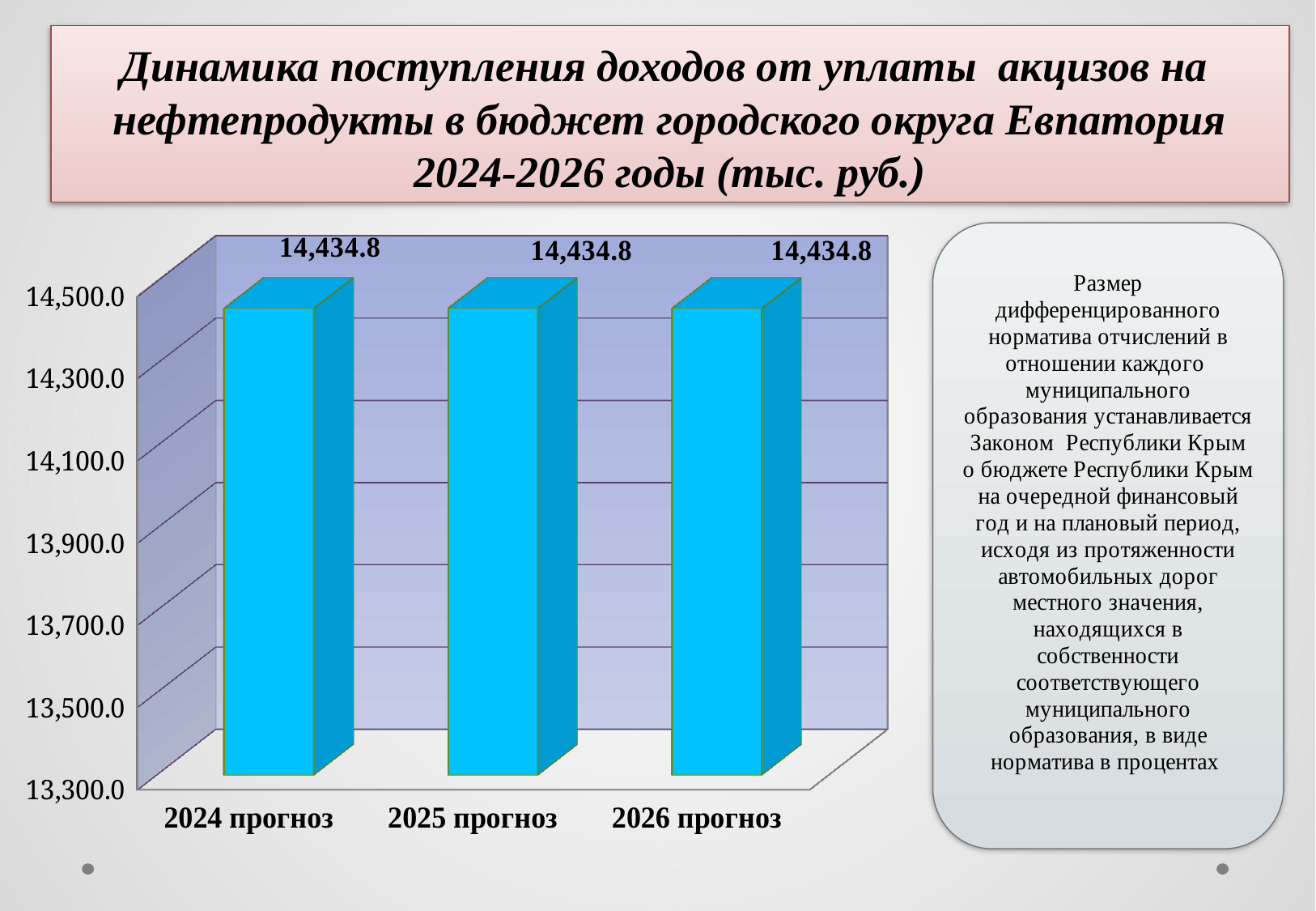
What kind of chart is shown on the slide? bar chart Is the value for 2025 прогноз greater or less than 14,300.0? greater What unit of measurement is stated in the slide title? тыс. руб. Is the value for 2024 прогноз greater or less than 14,500.0? less How many categories are shown on the x axis? 3 What is the difference between the values for 2024 прогноз and 2026 прогноз? 0.0 What is the lowest value shown on the vertical axis? 13,300.0 What is the value for 2026 прогноз? 14,434.8 What is the value for 2024 прогноз? 14,434.8 What is the value for 2025 прогноз? 14,434.8 Do the values rise, fall or stay the same from 2024 прогноз to 2026 прогноз? stay the same